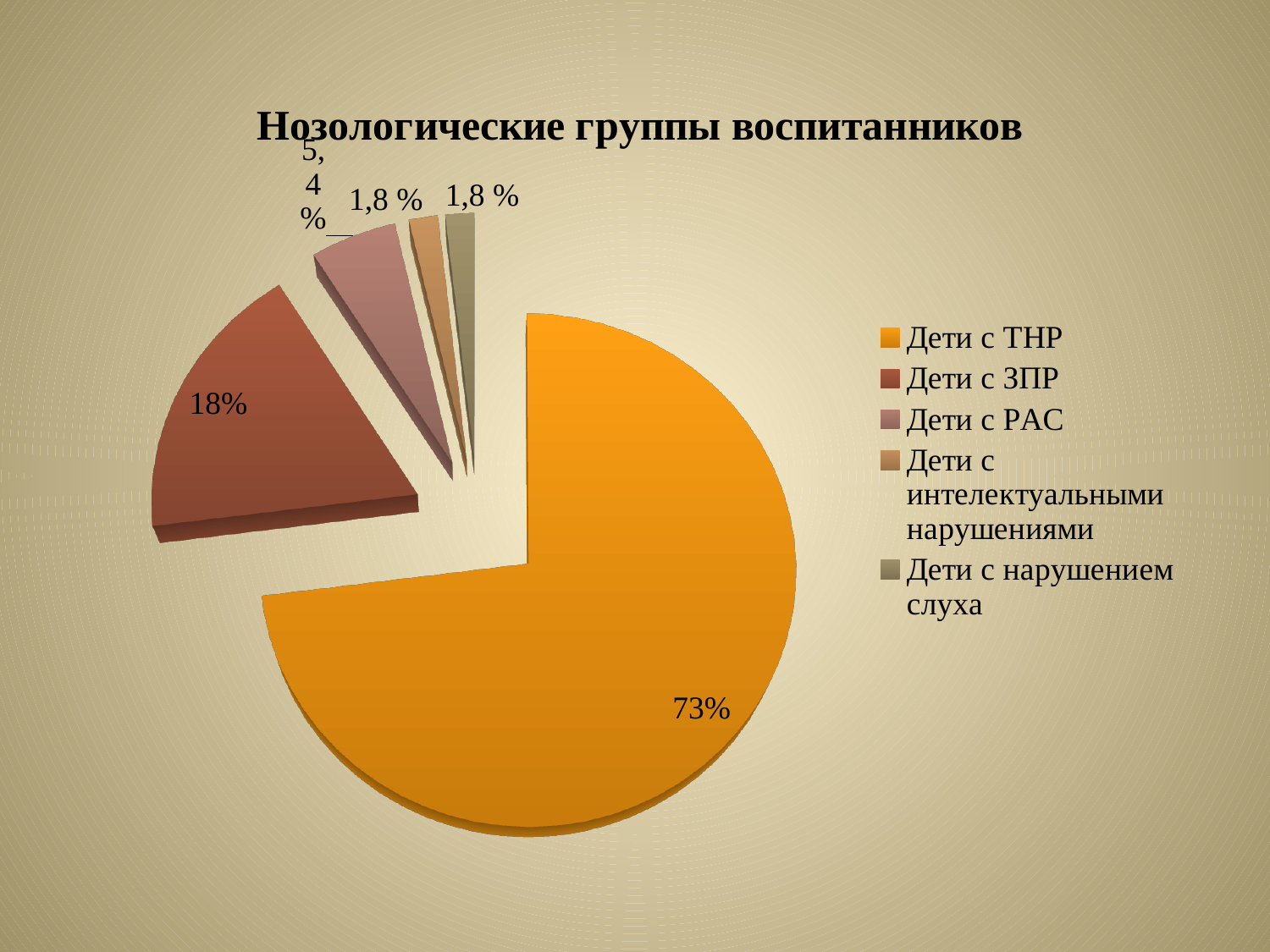
How many percentage points larger is the share for Дети с ТНР than the share for Дети с ЗПР? 55 Which slice is larger: Дети с ЗПР or Дети с РАС? Дети с ЗПР What share of the pie is labelled for Дети с РАС? 5,4 % What type of chart is shown on the slide? pie chart What share of the pie is labelled for Дети с ТНР? 73% Which group has the largest slice of the pie? Дети с ТНР How many groups does the legend list? 5 What is the smallest percentage shown on the pie chart? 1,8 % What share of the pie is labelled for Дети с интелектуальными нарушениями? 1,8 % What share of the pie is labelled for Дети с ЗПР? 18% What share of the pie is labelled for Дети с нарушением слуха? 1,8 % What is the title of the chart? Нозологические группы воспитанников